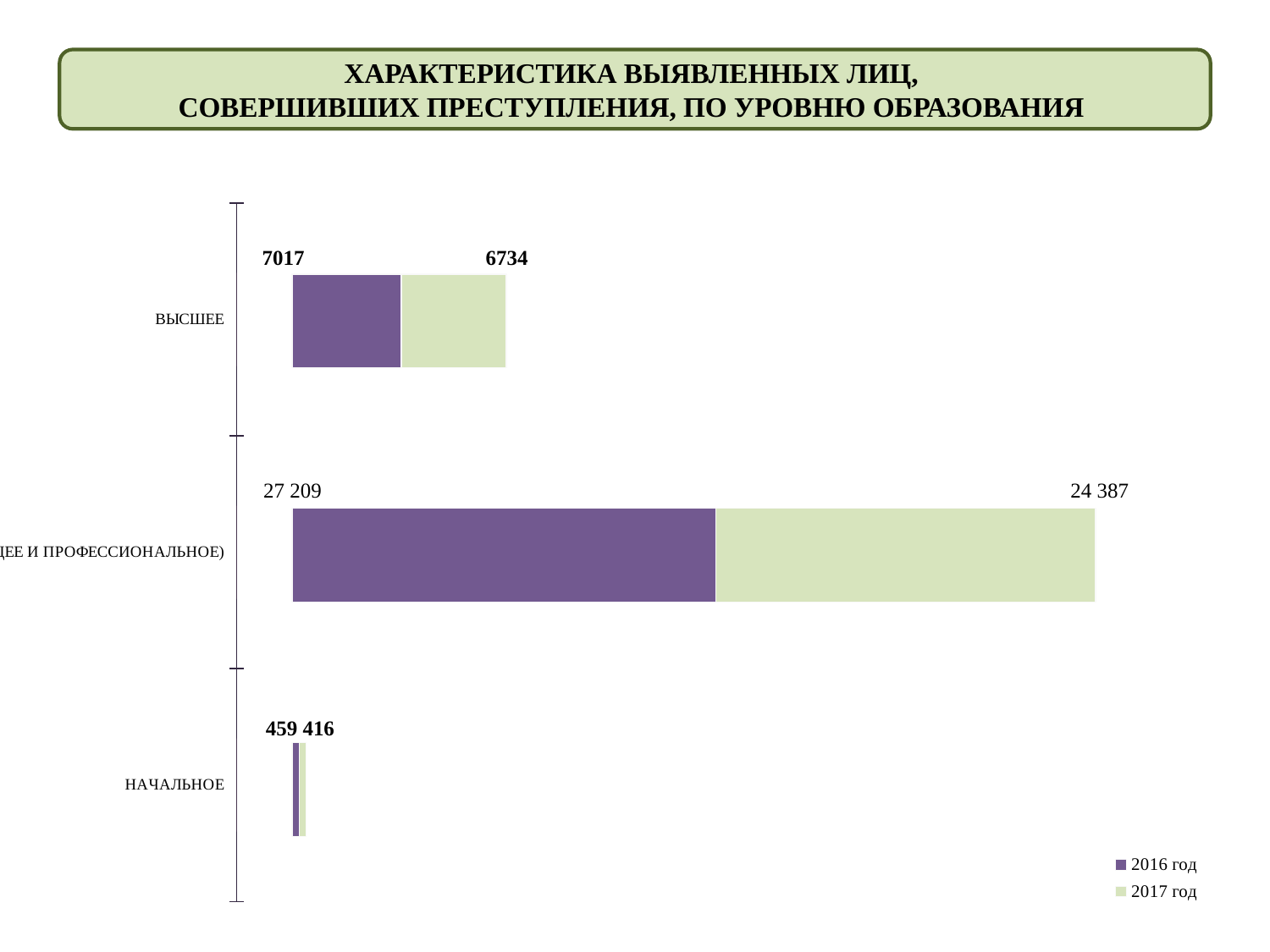
Which category has the lowest value for 2016 год? НАЧАЛЬНОЕ How many series does the legend list? 2 What is the value for ВЫСШЕЕ in 2017 год? 6734 Which series is shown in purple? 2016 год What is the value for ВЫСШЕЕ in 2016 год? 7017 What type of chart is shown on the slide? bar chart What is the value for НАЧАЛЬНОЕ in 2016 год? 459 Which is larger for ВЫСШЕЕ: the 2016 год value or the 2017 год value? 2016 год What is the total of the stacked bar for ВЫСШЕЕ? 13751 What is the value for НАЧАЛЬНОЕ in 2017 год? 416 What is the difference between the 2016 год and 2017 год values for ВЫСШЕЕ? 283 What is the difference between the 2016 год and 2017 год values for НАЧАЛЬНОЕ? 43